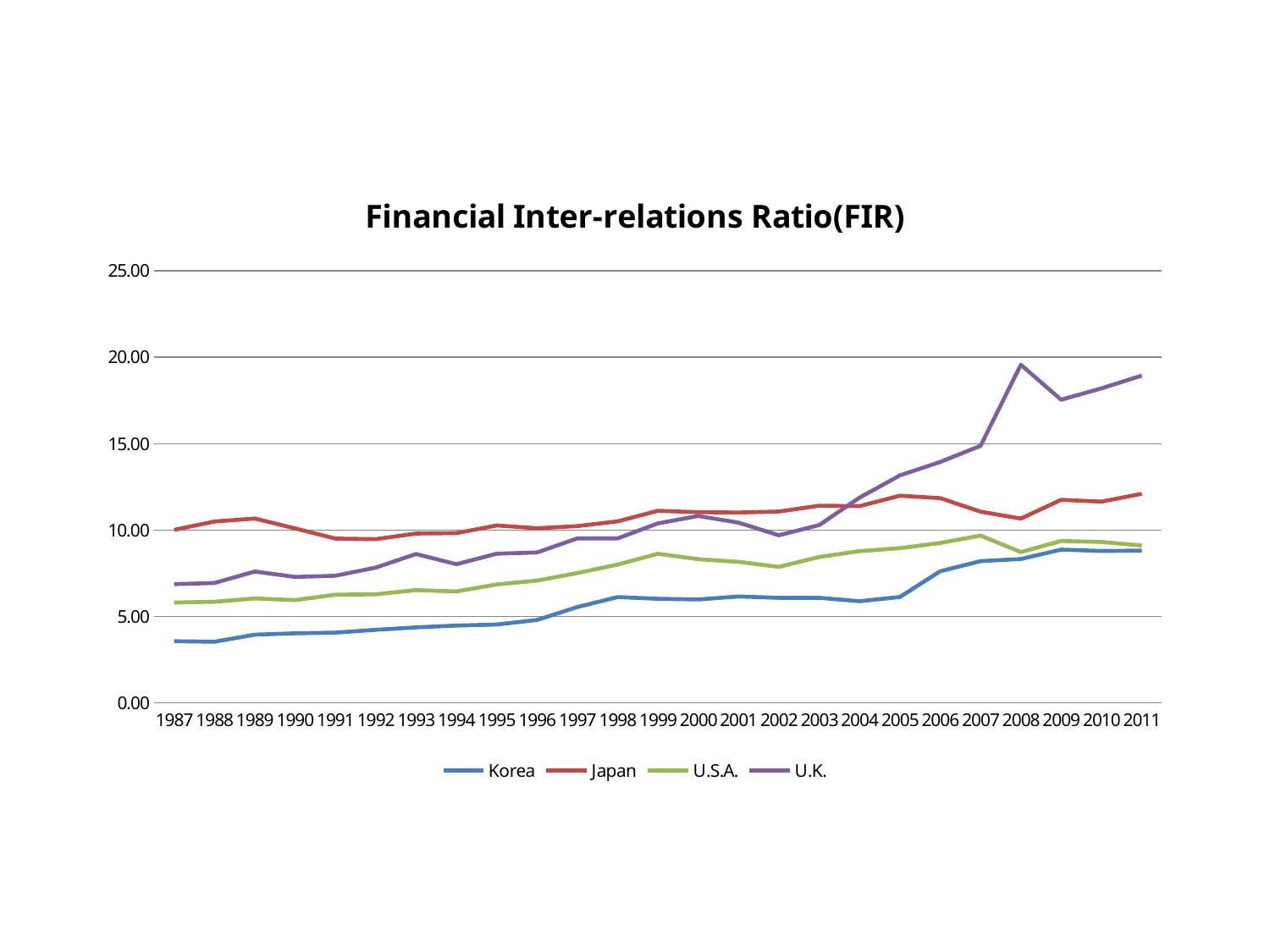
In which year does the U.K. line reach its highest value? 2008 Is the value for U.K. in 2008 greater or less than 15.00? greater In 2000, which is larger: the value for Japan or the value for U.S.A.? Japan What kind of chart is shown on the slide? line chart Is the value for Korea in 1987 greater or less than 5.00? less Which series has the lowest value in 1987? Korea Is the value for Japan in 2011 greater or less than 10.00? greater What is the title of the chart? Financial Inter-relations Ratio(FIR) How many series does the legend list? 4 Which series has the highest value in 2011? U.K. Does the Korea line generally rise or fall from 1987 to 2011? rise How many years are plotted along the x axis? 25